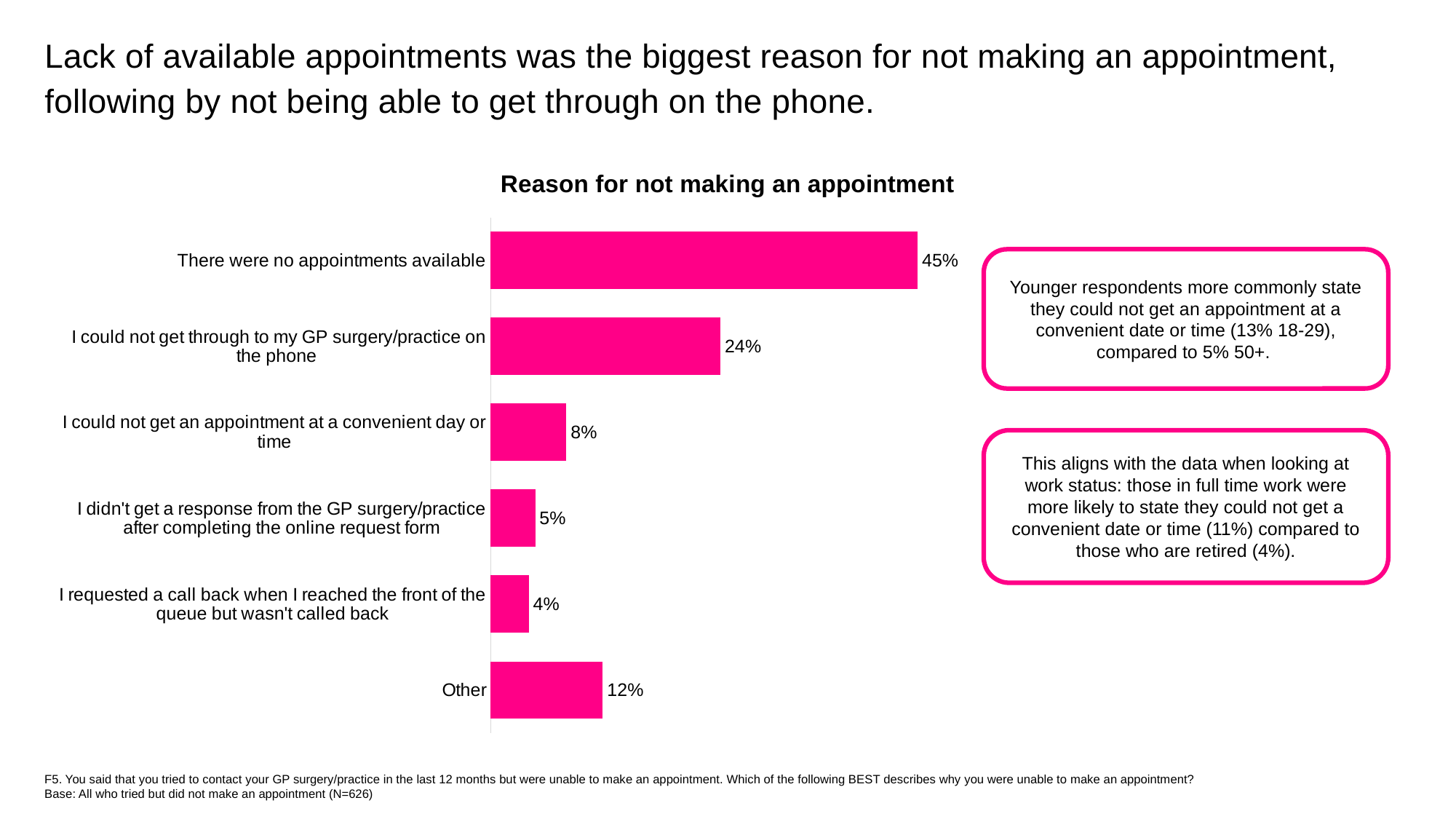
What is the difference in percentage points between 'There were no appointments available' and 'I could not get through to my GP surgery/practice on the phone'? 21 percentage points Which is larger: the value for 'Other' or the value for 'I could not get an appointment at a convenient day or time'? Other What is the difference between the values for 'I didn't get a response from the GP surgery/practice after completing the online request form' and 'I could not get an appointment at a convenient day or time'? 3 percentage points What is the value for 'I could not get through to my GP surgery/practice on the phone'? 24% What percentage is shown for 'Other'? 12% What is the title of the chart? Reason for not making an appointment What kind of chart is shown on the slide? Bar chart How many reasons (categories) are shown in the chart? 6 What percentage of respondents said there were no appointments available? 45% Which reason has the lowest percentage? I requested a call back when I reached the front of the queue but wasn't called back What is the value for 'I requested a call back when I reached the front of the queue but wasn't called back'? 4% Which reason has the highest percentage? There were no appointments available